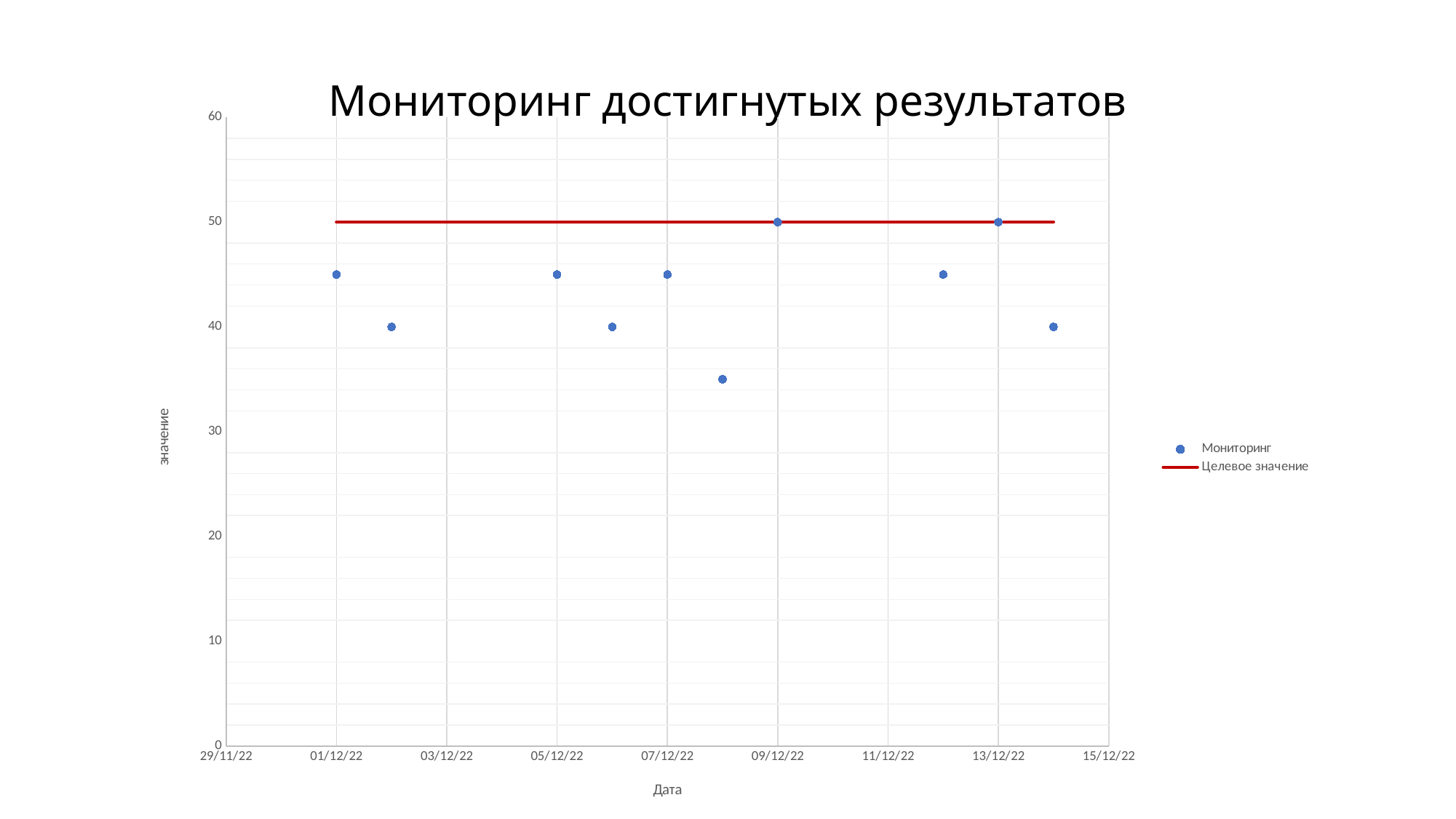
Is the Мониторинг value on 05/12/22 greater or less than 40? greater How many data points are plotted for the Мониторинг series? 10 What type of chart is shown on the slide? Scatter chart What is the value of the Целевое значение line? 50 How many Мониторинг points reach the Целевое значение line? 2 Which is larger, the Мониторинг value on 09/12/22 or on 07/12/22? 09/12/22 What is the Мониторинг value on 09/12/22? 50 Is the Мониторинг value on 01/12/22 greater or less than 50? less What is the Мониторинг value on 13/12/22? 50 Is the Мониторинг value on 07/12/22 greater or less than 50? less What is the title of the chart? Мониторинг достигнутых результатов How many series does the legend list? 2